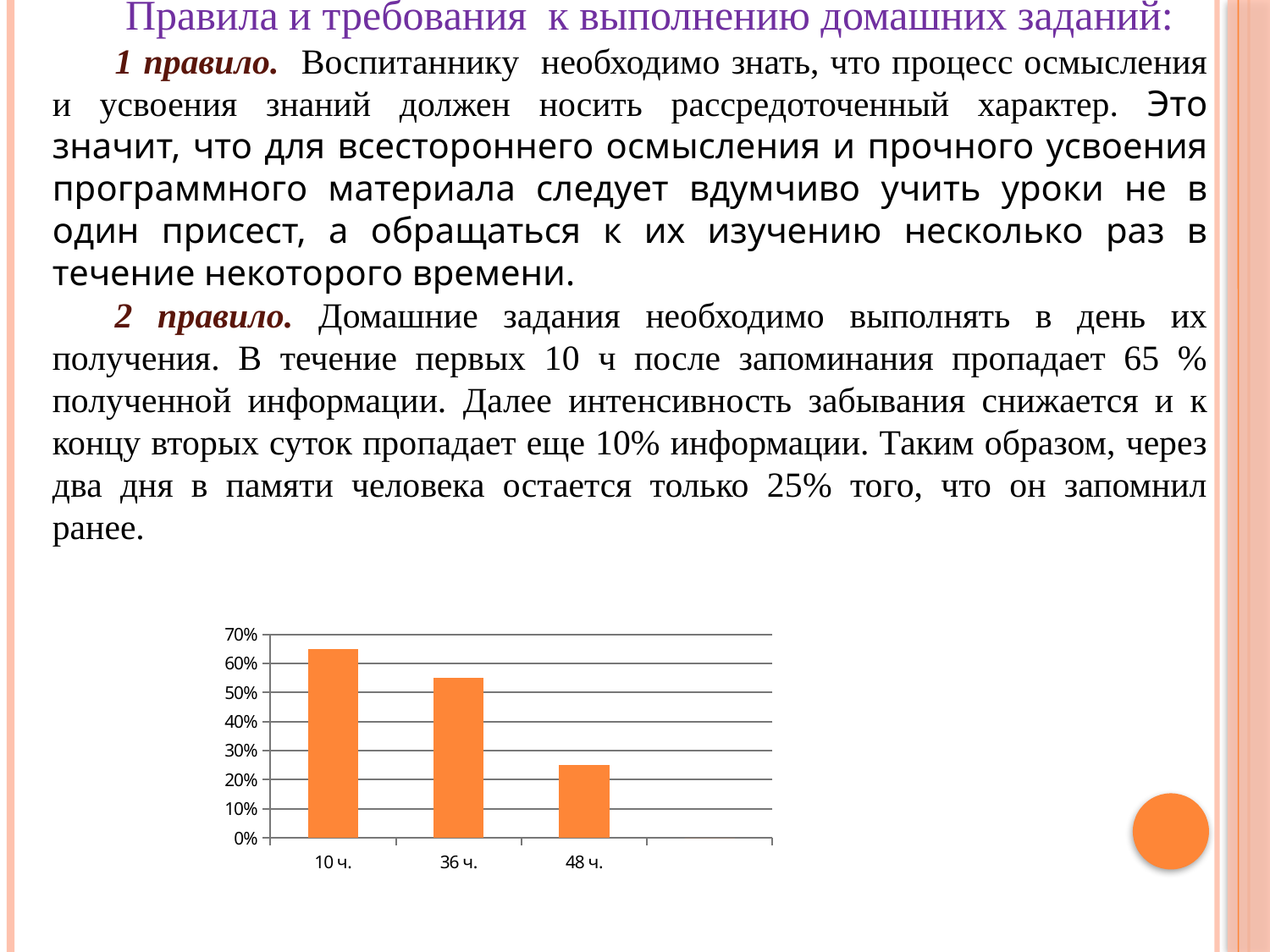
What kind of chart is shown on the slide? bar chart Do the values rise or fall from 10 ч. to 48 ч. along the x axis? fall Which category has the highest bar on the chart? 10 ч. Is the value for 48 ч. greater or less than 30%? less Is the value for 36 ч. greater or less than 50%? greater Is the value for 10 ч. greater or less than 60%? greater How many categories are plotted on the chart? 3 Which category has the lowest bar on the chart? 48 ч. Which is larger on the chart, the value for 10 ч. or the value for 36 ч.? 10 ч. What colour are the bars on the chart? orange Which is larger on the chart, the value for 36 ч. or the value for 48 ч.? 36 ч.